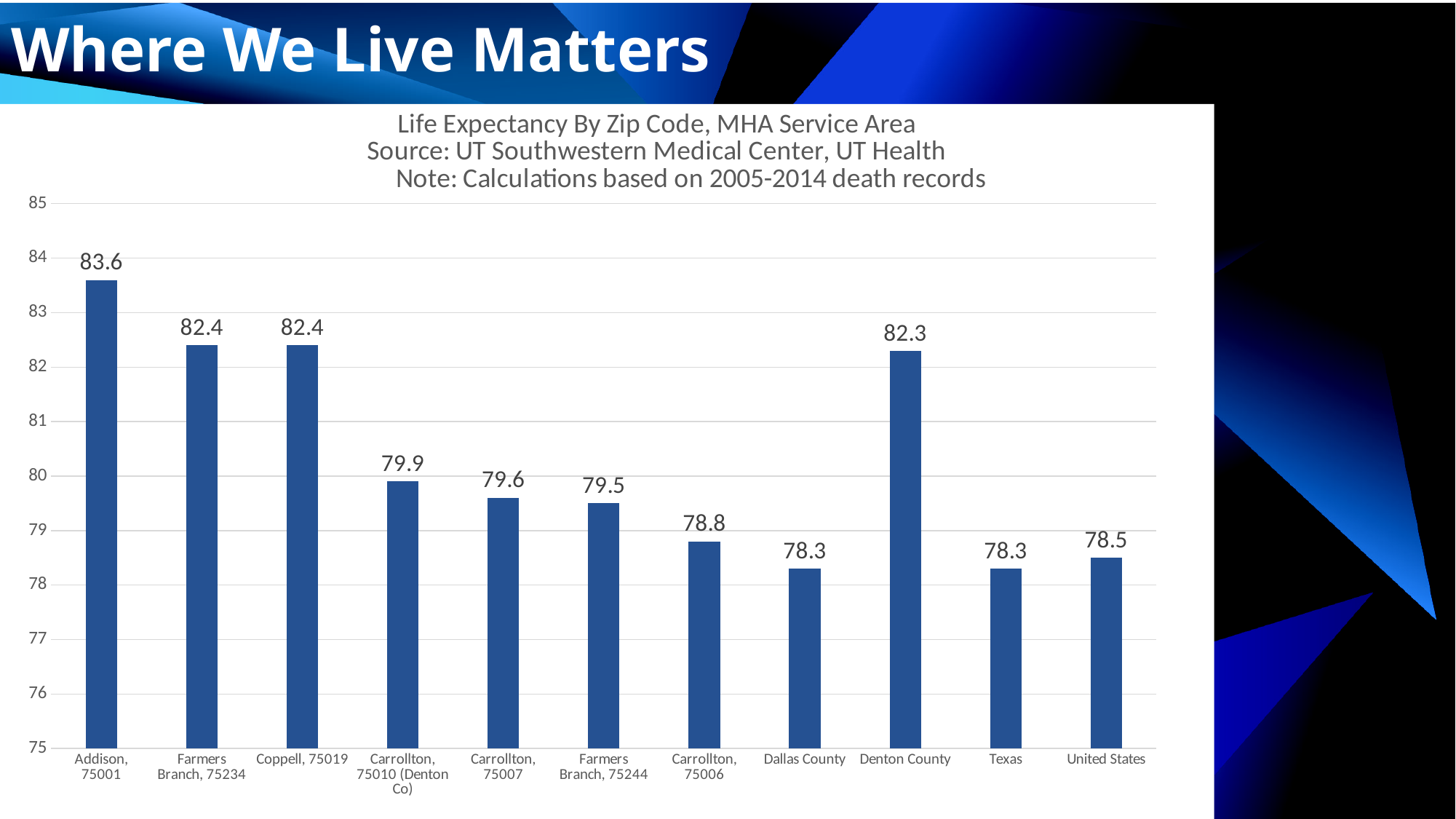
What is the life expectancy for the United States? 78.5 What is the difference in life expectancy between Denton County and Texas? 4.0 What is the life expectancy for Addison, 75001? 83.6 Which zip code or area has the highest life expectancy? Addison, 75001 What type of chart is shown on the slide? Bar chart What is the life expectancy for Denton County? 82.3 Which has a higher life expectancy, Coppell, 75019 or Carrollton, 75007? Coppell, 75019 What is the title of the chart? Life Expectancy By Zip Code, MHA Service Area Which has a higher life expectancy, Carrollton, 75010 (Denton Co) or Farmers Branch, 75244? Carrollton, 75010 (Denton Co) What is the difference in life expectancy between Addison, 75001 and Dallas County? 5.3 How many zip codes or areas are shown in the chart? 11 What is the life expectancy for Carrollton, 75006? 78.8